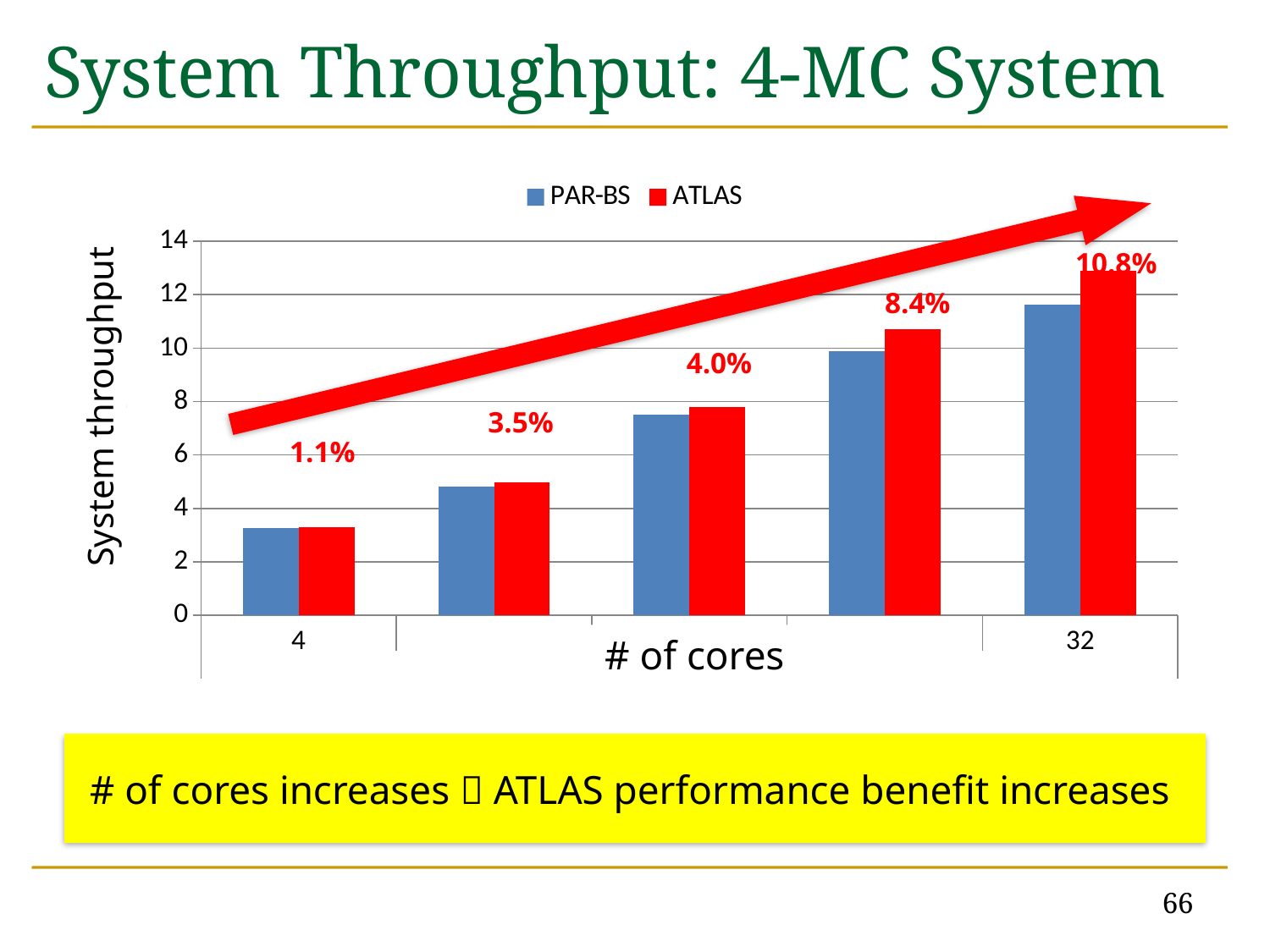
Which number of cores has the highest system throughput? 32 Is the ATLAS system throughput for 32 cores greater or less than 12? greater Is the PAR-BS system throughput for 32 cores greater or less than 10? greater How many groups of bars are plotted along the x axis? 5 At 32 cores, which series has the larger system throughput, PAR-BS or ATLAS? ATLAS How many series does the legend list? 2 What kind of chart is shown on the slide? bar chart Is the PAR-BS system throughput for 4 cores greater or less than 4? less Do the system throughput values rise or fall as the number of cores increases? rise Which colour represents the ATLAS series in the legend? red What is the title of the slide containing the chart? System Throughput: 4-MC System Which number of cores has the lowest system throughput? 4